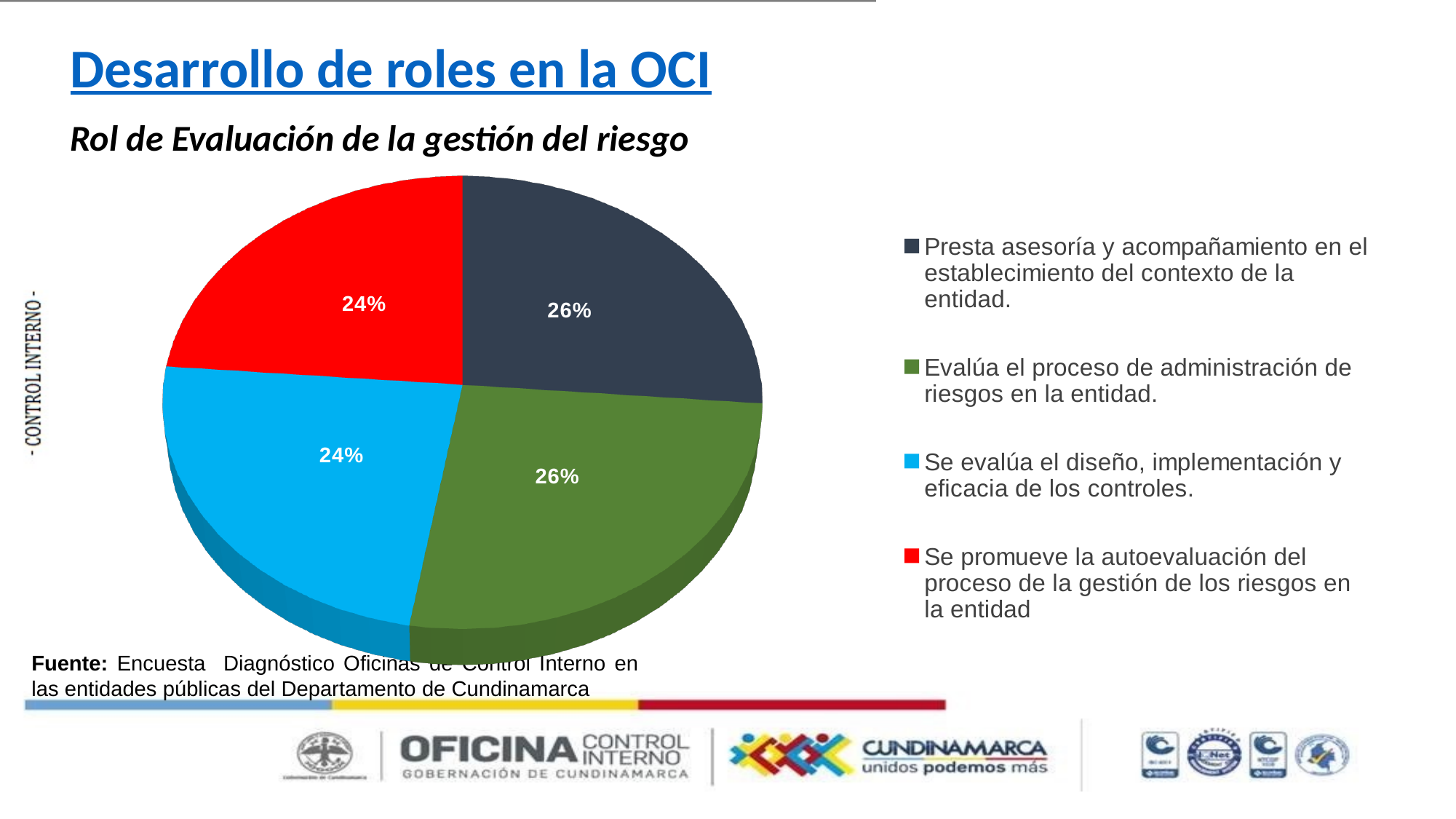
What percentage is shown for the slice 'Evalúa el proceso de administración de riesgos en la entidad'? 26% What share of the pie do the two 24% slices make up together? 48% How many slices does the pie chart have? 4 What percentage is shown for the slice 'Se promueve la autoevaluación del proceso de la gestión de los riesgos en la entidad'? 24% What is the difference in percentage points between the 'Evalúa el proceso de administración de riesgos en la entidad' slice and the 'Se promueve la autoevaluación del proceso de la gestión de los riesgos en la entidad' slice? 2 percentage points What percentage is shown for the slice 'Se evalúa el diseño, implementación y eficacia de los controles'? 24% What is the subtitle shown above the pie chart? Rol de Evaluación de la gestión del riesgo How many entries does the legend list? 4 What percentage is shown for the slice 'Presta asesoría y acompañamiento en el establecimiento del contexto de la entidad'? 26% What kind of chart is shown on the slide? Pie chart What colour is the slice for 'Se promueve la autoevaluación del proceso de la gestión de los riesgos en la entidad'? Red Which is larger: the slice for 'Presta asesoría y acompañamiento en el establecimiento del contexto de la entidad' or the slice for 'Se evalúa el diseño, implementación y eficacia de los controles'? Presta asesoría y acompañamiento en el establecimiento del contexto de la entidad